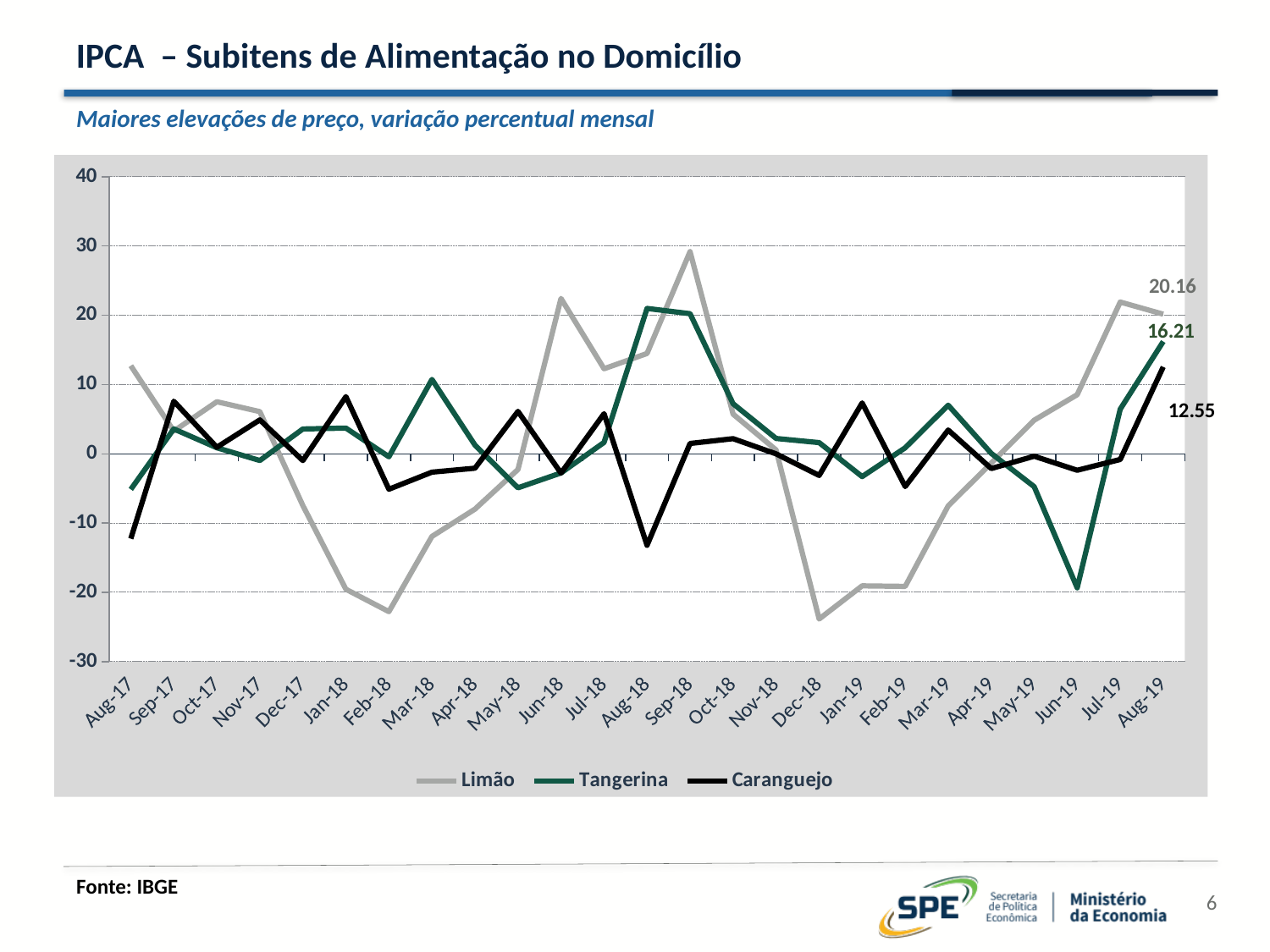
What is the difference between the Limão and Caranguejo values in Aug-19? 7.61 What is the difference between the Limão and Tangerina values in Aug-19? 3.95 Which series has the lowest value in Aug-19? Caranguejo What is the value for Tangerina in Aug-19? 16.21 What is the value for Limão in Aug-19? 20.16 Is the value for Limão in Dec-18 greater or less than -20? less How many series does the legend list? 3 Is the value for Tangerina in Jun-19 greater or less than -10? less What kind of chart is shown on the slide? Line chart Is the value for Limão in Sep-18 greater or less than 20? greater What is the value for Caranguejo in Aug-19? 12.55 Which series has the highest value in Aug-19? Limão